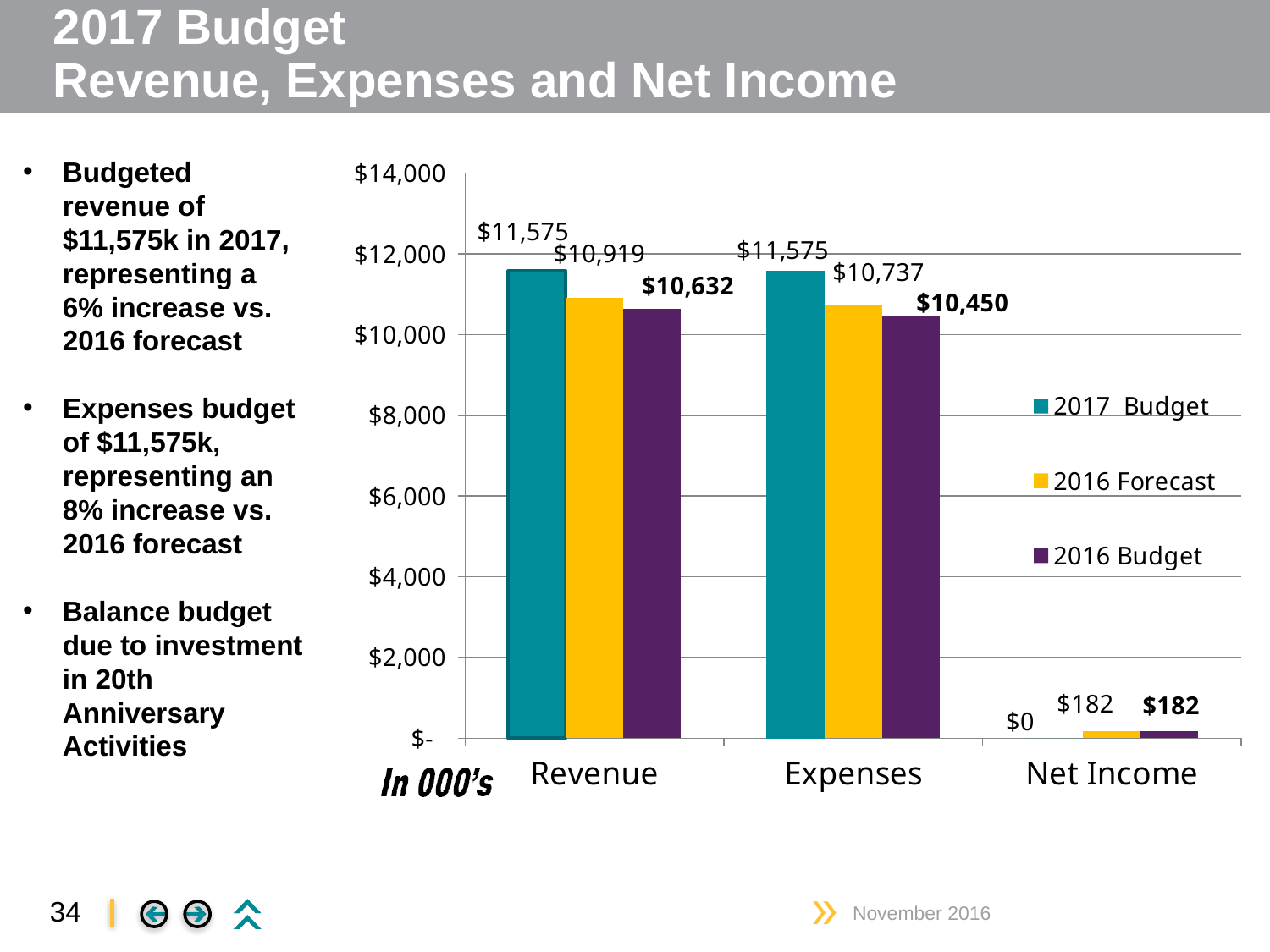
How many categories are shown on the x axis? 3 Which category has the lowest 2016 Budget value? Net Income What is the difference between the 2016 Forecast values for Revenue and Expenses? $182 What is the 2016 Forecast value for Net Income? $182 How many series does the legend list? 3 Which is larger for Revenue: the 2016 Forecast or the 2016 Budget? 2016 Forecast What is the difference between the 2017 Budget and 2016 Budget values for Expenses? $1,125 What is the 2016 Budget value for Revenue? $10,632 What is the 2017 Budget value for Revenue? $11,575 What is the 2017 Budget value for Net Income? $0 What kind of chart is shown on the slide? Bar chart What is the 2016 Forecast value for Expenses? $10,737